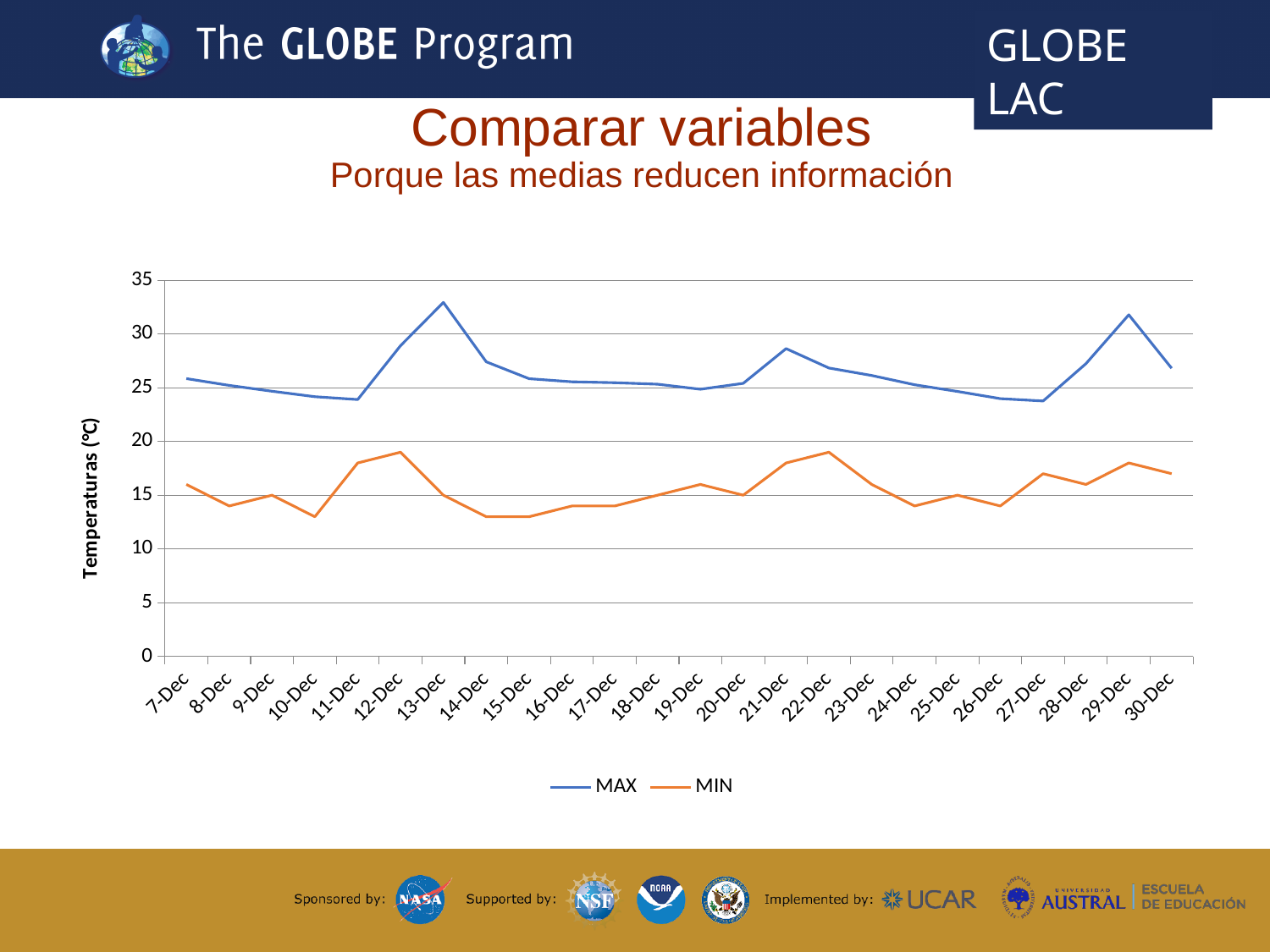
How many series does the legend list? 2 What is the label of the vertical axis? Temperaturas (°C) How many dates are plotted along the x axis? 24 Is the MAX value on 27-Dec greater or less than 25? less Is the MIN value on 22-Dec greater or less than 15? greater Does the MAX series rise or fall from 7-Dec to 11-Dec? fall On which date does the MAX series reach its highest value? 13-Dec What kind of chart is shown on the slide? line chart Is the MAX value on 13-Dec greater or less than 30? greater Which series has the larger value on 20-Dec, MAX or MIN? MAX Which colour is used for the MIN series? orange